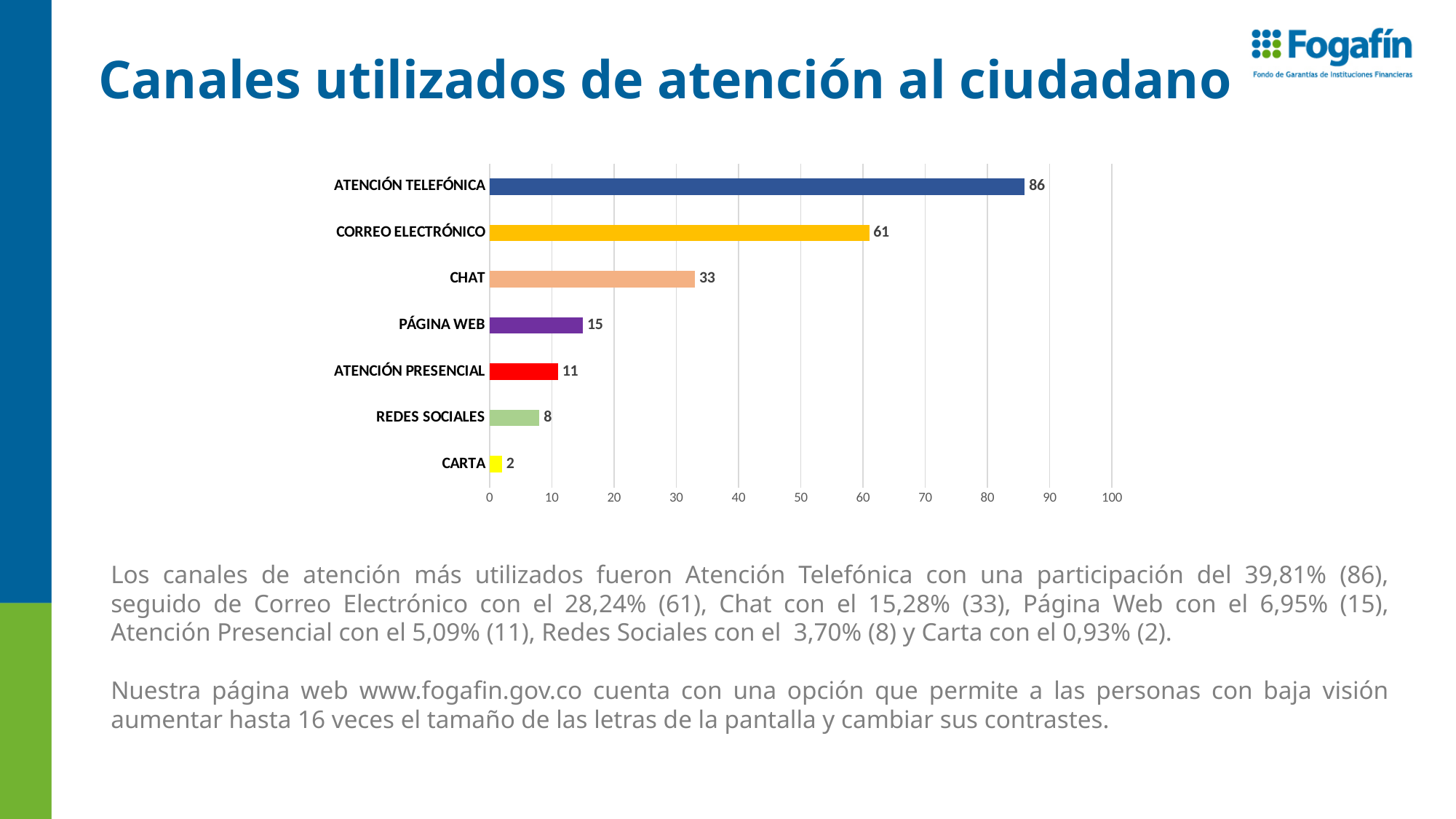
What is the value for ATENCIÓN TELEFÓNICA? 86 What is the difference between the values for ATENCIÓN TELEFÓNICA and CORREO ELECTRÓNICO? 25 Which category has the highest value? ATENCIÓN TELEFÓNICA What colour is the bar for ATENCIÓN PRESENCIAL? Red What is the value for CHAT? 33 How many categories are shown in the chart? 7 What kind of chart is shown on the slide? Bar chart What is the value for REDES SOCIALES? 8 What is the value for CORREO ELECTRÓNICO? 61 Which category has the lowest value? CARTA What is the difference between the values for PÁGINA WEB and ATENCIÓN PRESENCIAL? 4 Which is larger, the value for CHAT or the value for PÁGINA WEB? CHAT